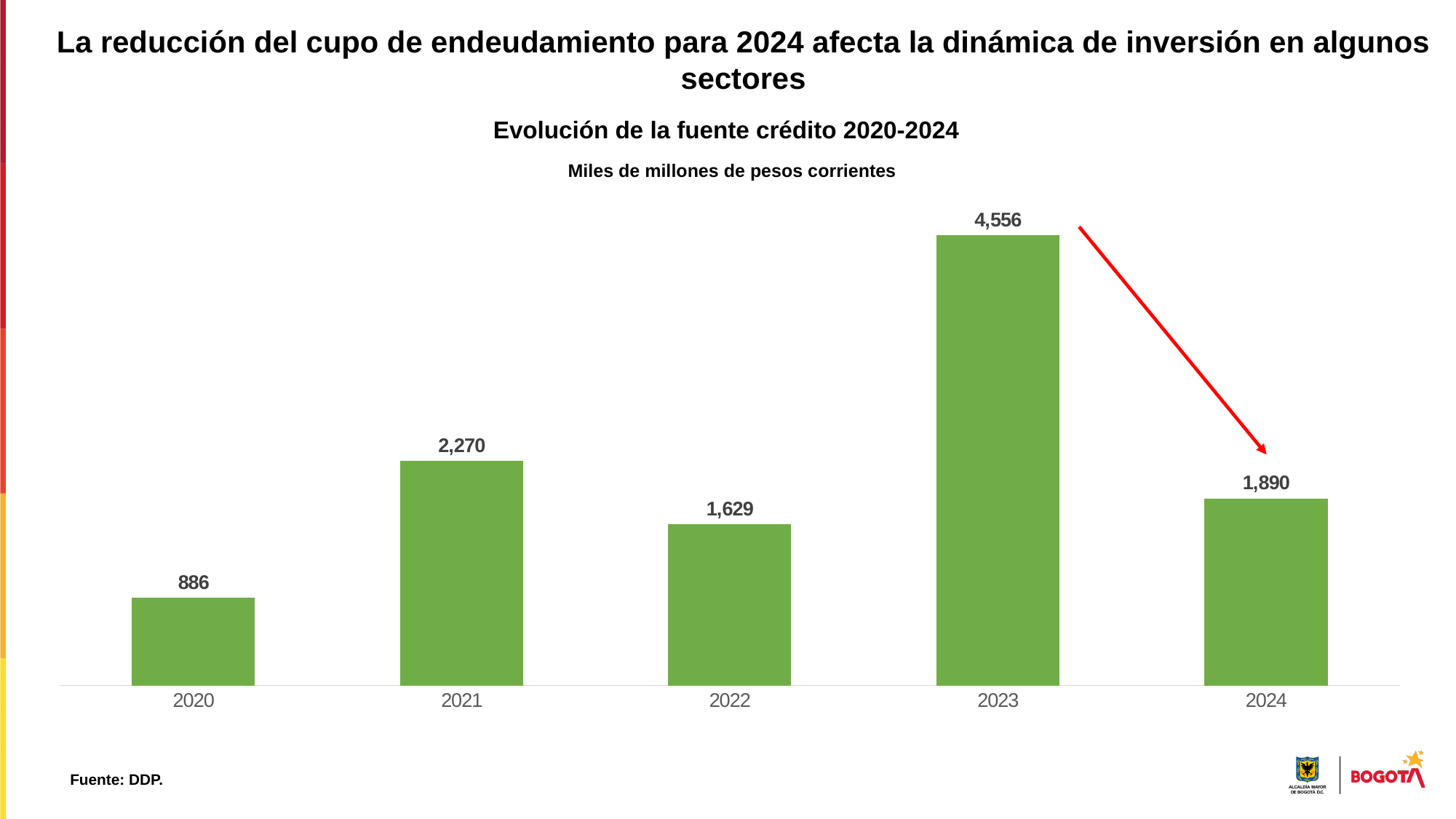
What kind of chart is shown on the slide? Bar chart What is the difference between the values for 2021 and 2022? 641 Which year has the lowest value? 2020 Which year has the highest value? 2023 Does the value rise or fall from 2023 to 2024? Fall How many years are shown on the chart? 5 What is the value for 2020? 886 Which is larger, the value for 2021 or the value for 2024? 2021 What is the value for 2024? 1,890 What is the value for 2023? 4,556 What is the difference between the values for 2023 and 2024? 2,666 What is the title of the chart? Evolución de la fuente crédito 2020-2024